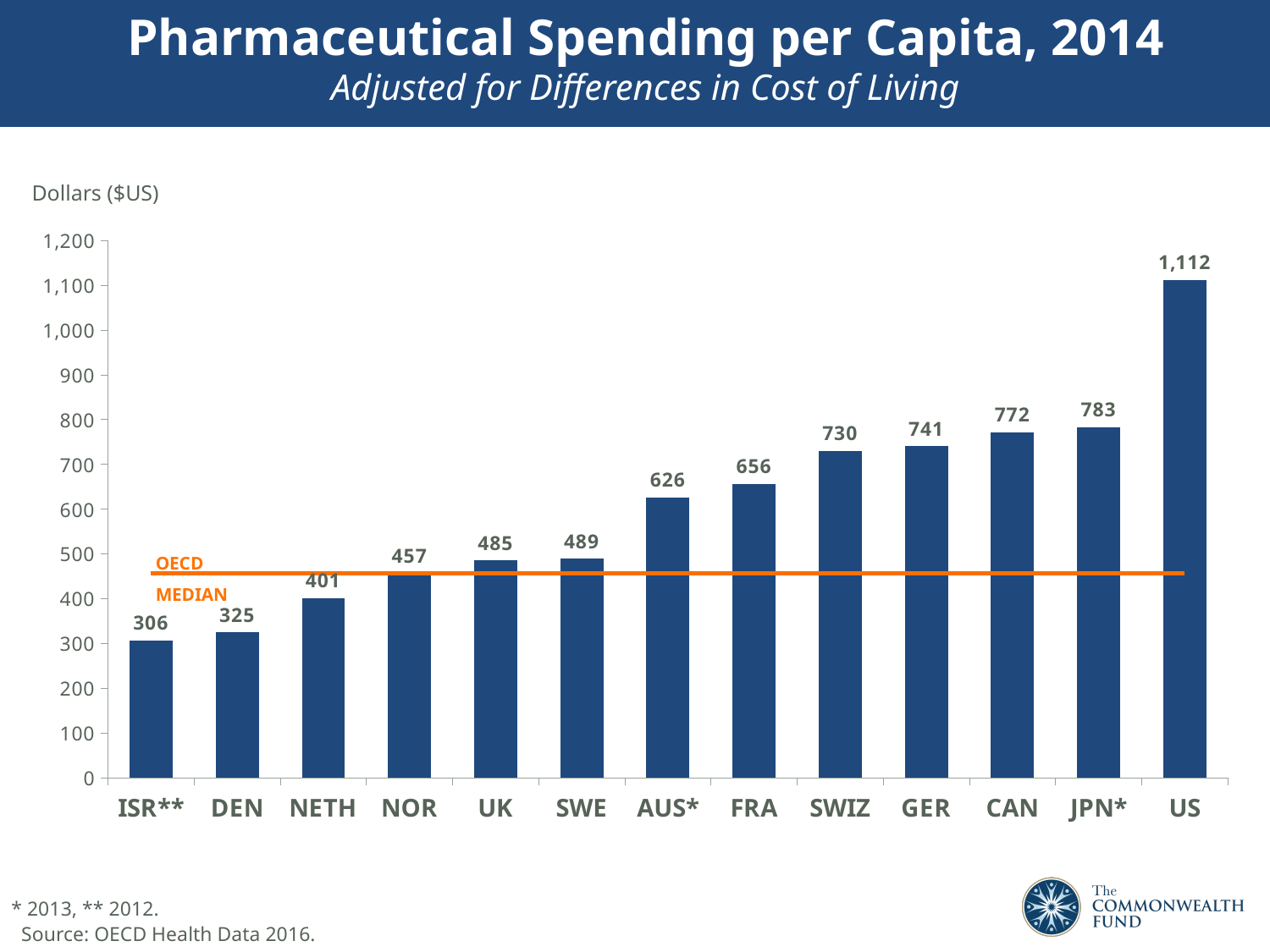
How many countries are shown in the chart? 13 Which country has the lowest pharmaceutical spending per capita? ISR** What is the pharmaceutical spending per capita for NETH? 401 What is the pharmaceutical spending per capita for the US? 1,112 What is the difference in pharmaceutical spending per capita between GER and SWIZ? 11 What kind of chart is shown on the slide? Bar chart What does the orange horizontal line on the chart represent? OECD MEDIAN What is the pharmaceutical spending per capita for FRA? 656 Which country has the highest pharmaceutical spending per capita? US Is the value for CAN greater or less than 700? greater Which has higher pharmaceutical spending per capita, AUS* or NOR? AUS* What is the difference in pharmaceutical spending per capita between the US and JPN*? 329